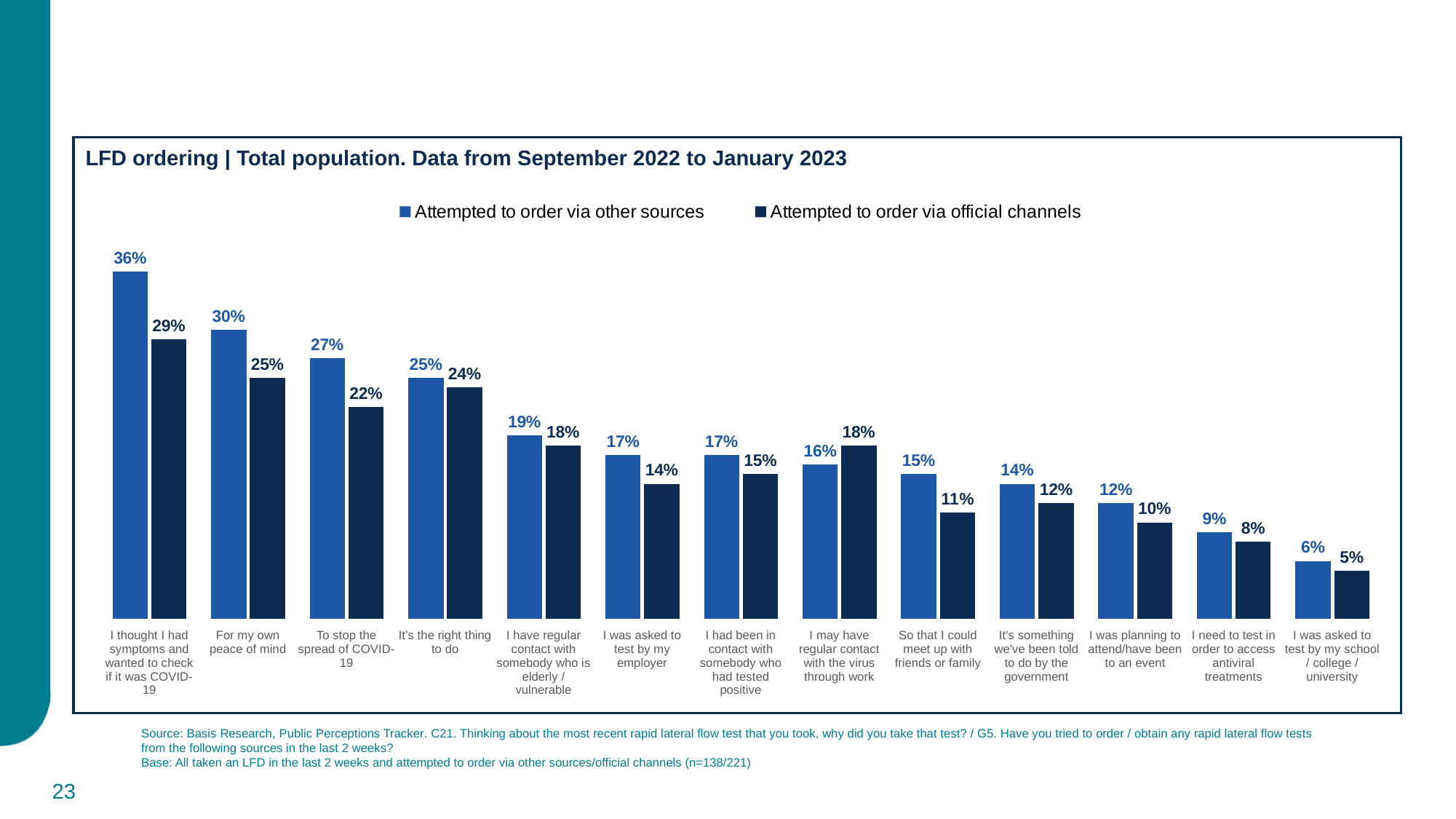
How many series does the legend list? 2 What is the title of the chart? LFD ordering | Total population. Data from September 2022 to January 2023 What is the value for "Attempted to order via official channels" for "For my own peace of mind"? 25% Do the values for "Attempted to order via other sources" rise or fall from left to right along the x axis? Fall How many categories are shown on the x axis? 13 What is the value for "Attempted to order via other sources" for "I thought I had symptoms and wanted to check if it was COVID-19"? 36% For "I may have regular contact with the virus through work", which series has the larger value? Attempted to order via official channels Which category has the lowest value for "Attempted to order via official channels"? I was asked to test by my school / college / university Which category has the highest value for "Attempted to order via other sources"? I thought I had symptoms and wanted to check if it was COVID-19 What is the value for "Attempted to order via official channels" for "I may have regular contact with the virus through work"? 18% What is the difference between the two series for "To stop the spread of COVID-19"? 5% What kind of chart is shown on the slide? Bar chart